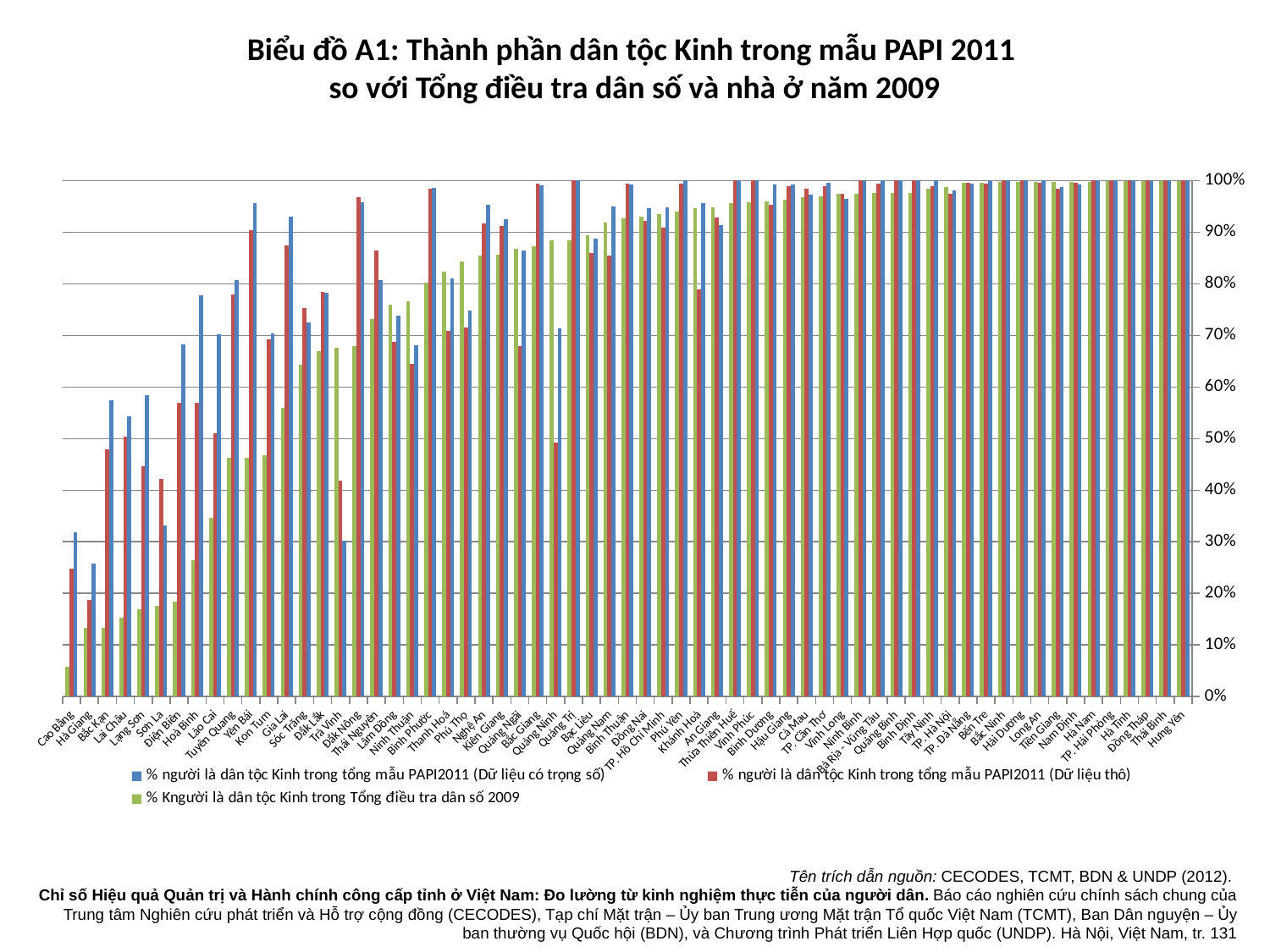
Is the red (PAPI2011 dữ liệu thô) value for Bắc Kạn greater or less than 40%? greater What is the chart number given in the title? Biểu đồ A1 Is the green (Tổng điều tra dân số 2009) value for Hà Giang greater or less than 20%? less Which series is shown in green in the legend? % Kngười là dân tộc Kinh trong Tổng điều tra dân số 2009 Is the blue (PAPI2011 dữ liệu có trọng số) value for Lai Châu greater or less than 50%? greater Which province has the lowest green (Tổng điều tra dân số 2009) value? Cao Bằng For Bắc Kạn, which is larger: the blue (dữ liệu có trọng số) bar or the red (dữ liệu thô) bar? the blue (dữ liệu có trọng số) bar For Lai Châu, which is larger: the blue (dữ liệu có trọng số) bar or the green (Tổng điều tra dân số 2009) bar? the blue (dữ liệu có trọng số) bar Do the green (Tổng điều tra dân số 2009) values generally rise or fall from left to right along the x axis? rise How many series does the legend list? 3 What kind of chart is shown on the slide? bar chart